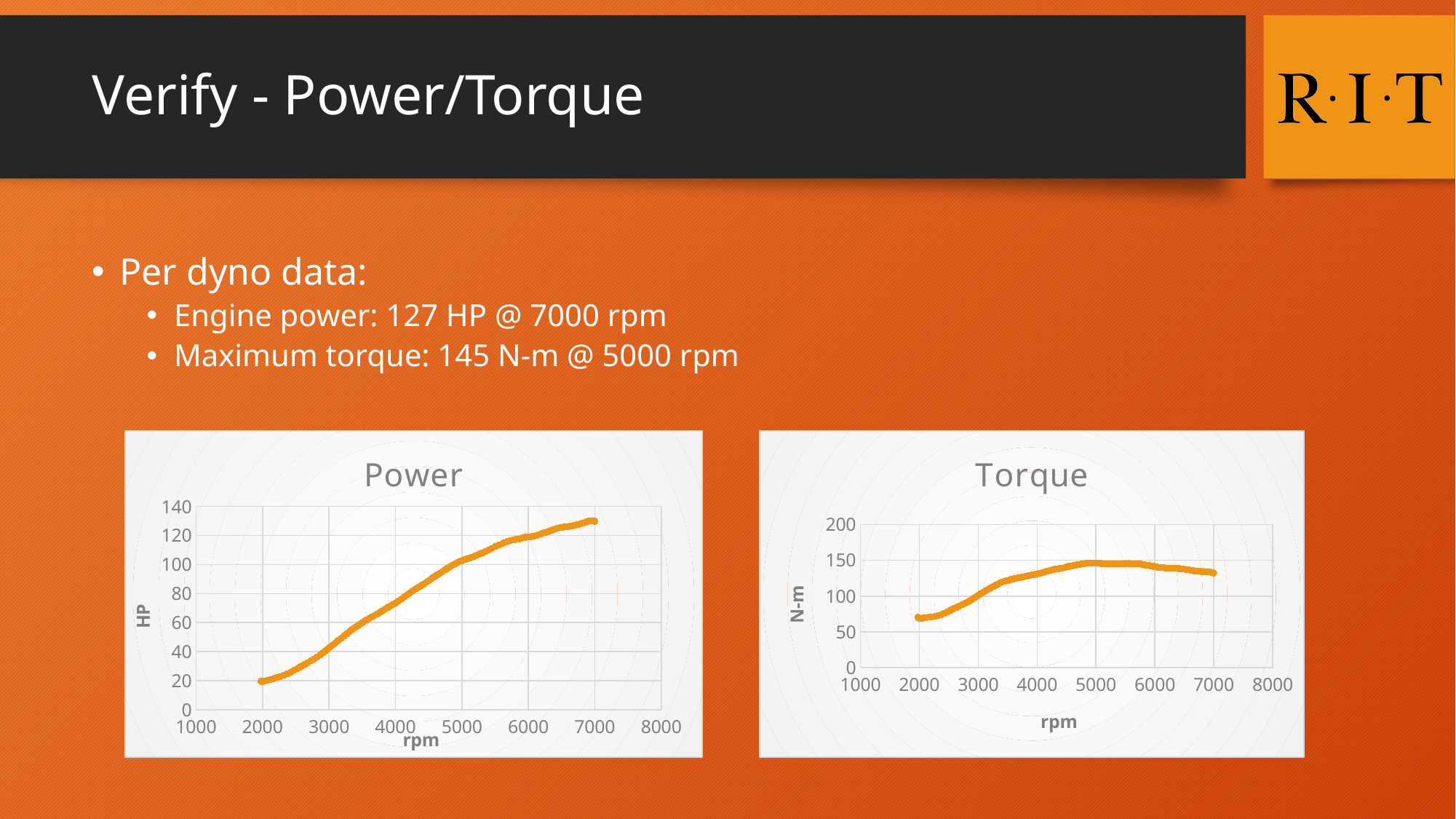
In the Torque chart, is the value at 2000 rpm greater or less than 100? less In the Torque chart, do the values rise or fall as rpm increases from 5000 to 7000? fall In the Power chart, is the value at 7000 rpm greater or less than 120? greater In the Power chart, at which rpm is the power highest? 7000 What kind of chart is the Torque chart? line chart What kind of chart is the Power chart? line chart In the Power chart, do the values rise or fall as rpm increases from 2000 to 7000? rise In the Torque chart, is the value at 7000 rpm greater or less than 100? greater What is the y-axis label of the Torque chart? N-m In the Torque chart, do the values rise or fall as rpm increases from 2000 to 5000? rise